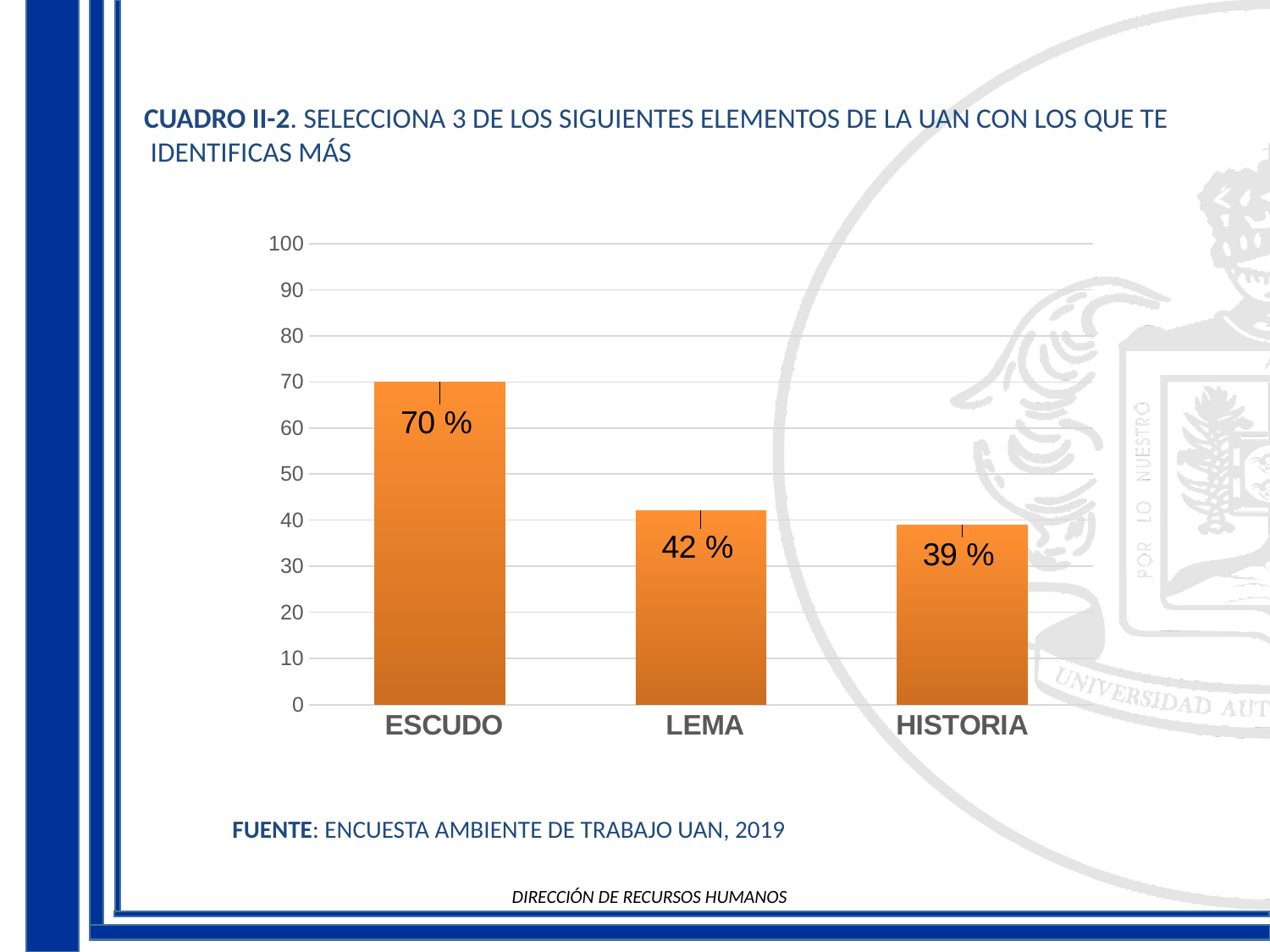
Is the value for LEMA greater or less than 50? less Which category has the lowest value? HISTORIA What is the value for ESCUDO? 70 % Which category has the highest value? ESCUDO What kind of chart is shown on the slide? bar chart How many categories are shown on the x axis? 3 What is the value for HISTORIA? 39 % What source is cited below the chart? ENCUESTA AMBIENTE DE TRABAJO UAN, 2019 Which is larger, the value for ESCUDO or the value for HISTORIA? ESCUDO What is the difference between the values for ESCUDO and LEMA? 28 % What is the difference between the values for LEMA and HISTORIA? 3 % What is the value for LEMA? 42 %